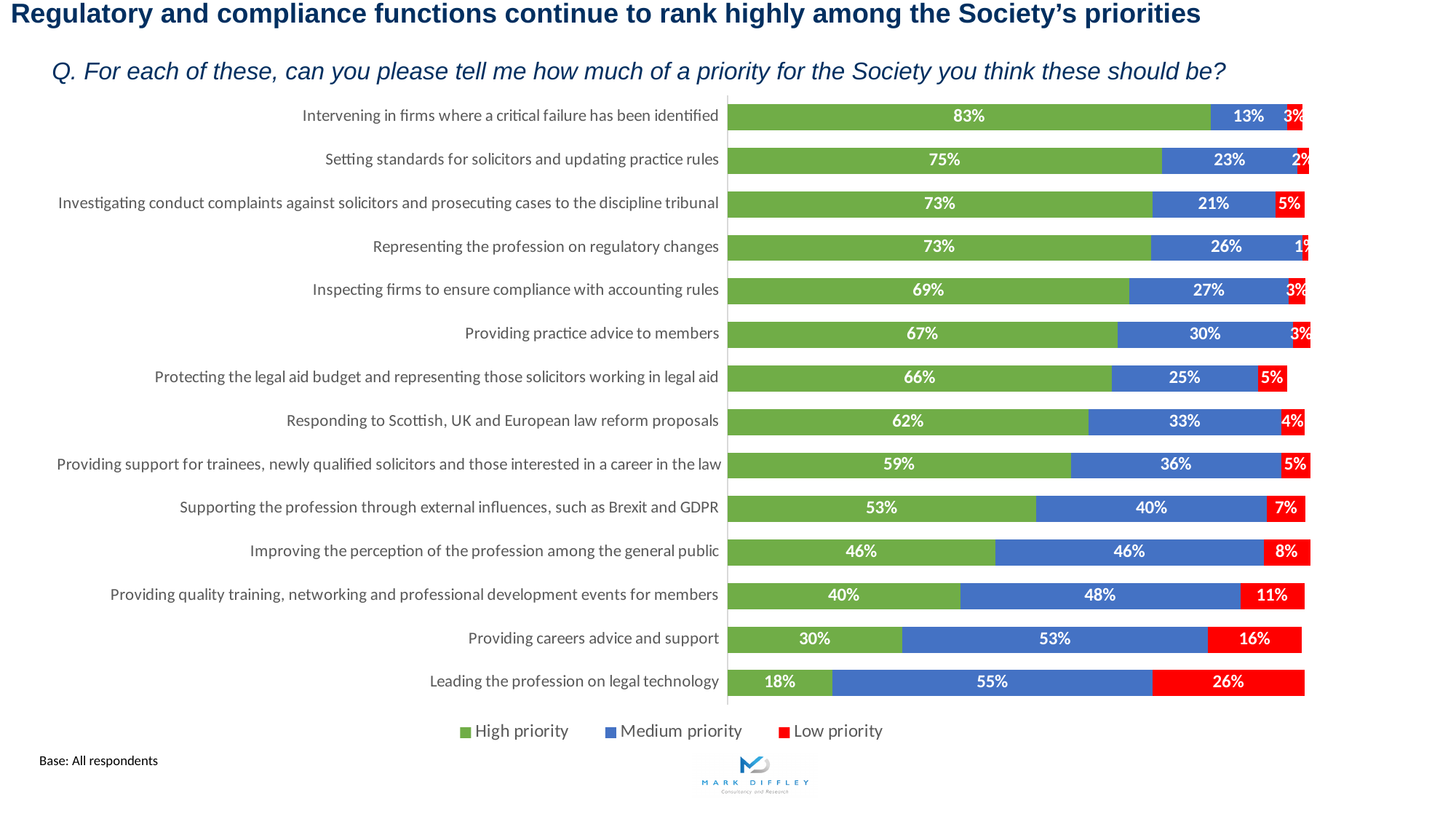
Which colour represents Low priority in the chart? Red Which category has the highest Low priority percentage? Leading the profession on legal technology How many categories are shown in the chart? 14 What percentage of respondents rated 'Intervening in firms where a critical failure has been identified' as a high priority? 83% What is the Medium priority value for 'Providing careers advice and support'? 53% Which category has the lowest High priority percentage? Leading the profession on legal technology What is the difference between the High priority values for 'Setting standards for solicitors and updating practice rules' and 'Providing practice advice to members'? 8% What is the Low priority value for 'Leading the profession on legal technology'? 26% Which category has the highest High priority percentage? Intervening in firms where a critical failure has been identified Which has a larger Medium priority value: 'Supporting the profession through external influences, such as Brexit and GDPR' or 'Responding to Scottish, UK and European law reform proposals'? Supporting the profession through external influences, such as Brexit and GDPR What type of chart is shown on the slide? Stacked bar chart How many series does the legend list? 3